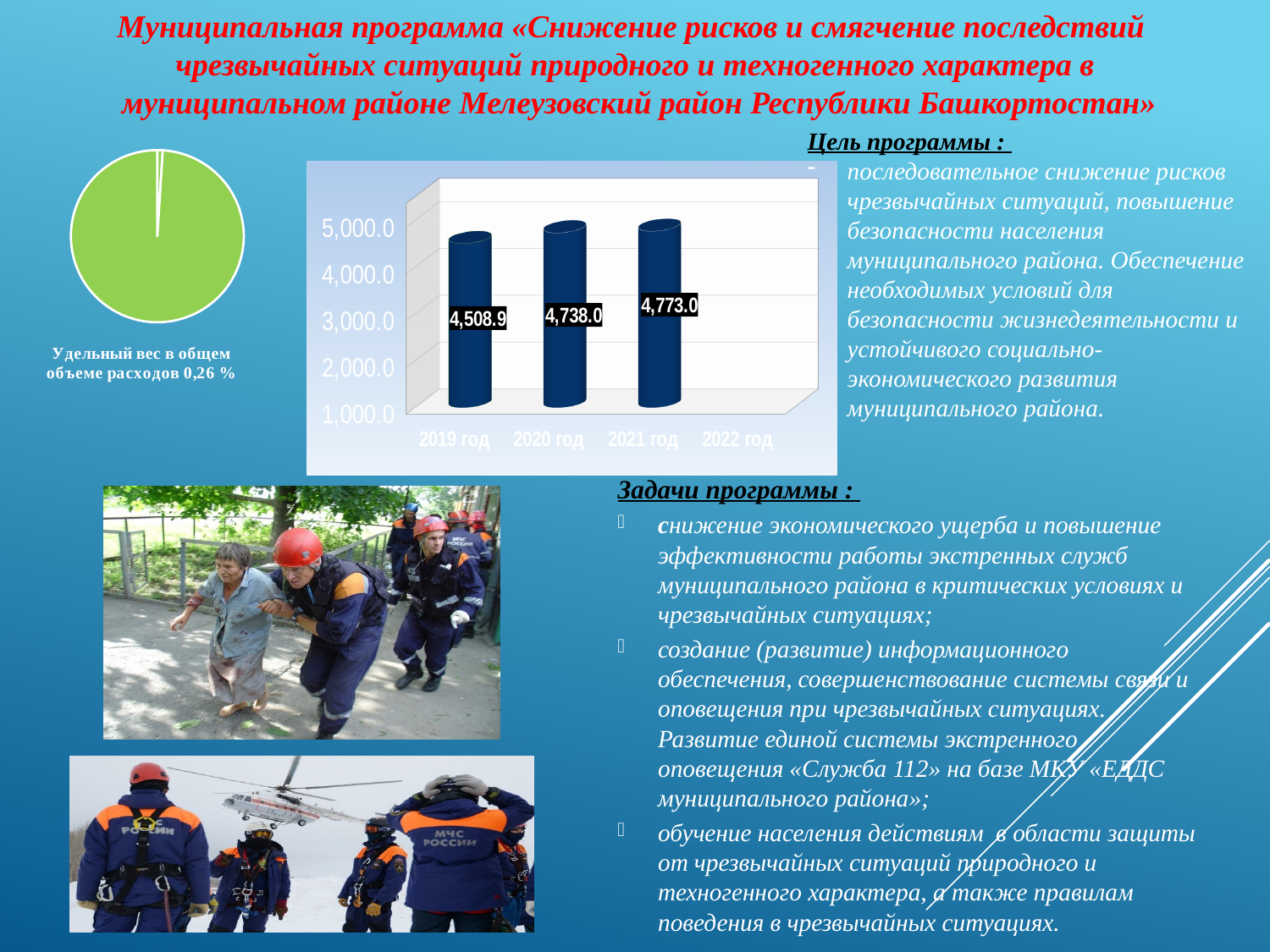
How many bars are plotted in the bar chart? 3 In the bar chart, which is larger, the value for 2020 год or the value for 2019 год? 2020 год In the bar chart, what is the difference between the values for 2021 год and 2019 год? 264.1 In the bar chart, which year has the highest value? 2021 год In the bar chart, what is the difference between the values for 2020 год and 2019 год? 229.1 In the bar chart, which year has the lowest value? 2019 год In the bar chart, what is the value for 2020 год? 4,738.0 In the bar chart, what is the value for 2019 год? 4,508.9 What kind of chart is shown on the left of the slide, below the title? pie chart In the bar chart, is the value for 2019 год greater or less than 4,000.0? greater In the bar chart, what is the value for 2021 год? 4,773.0 Do the values in the bar chart rise or fall from 2019 год to 2021 год? rise